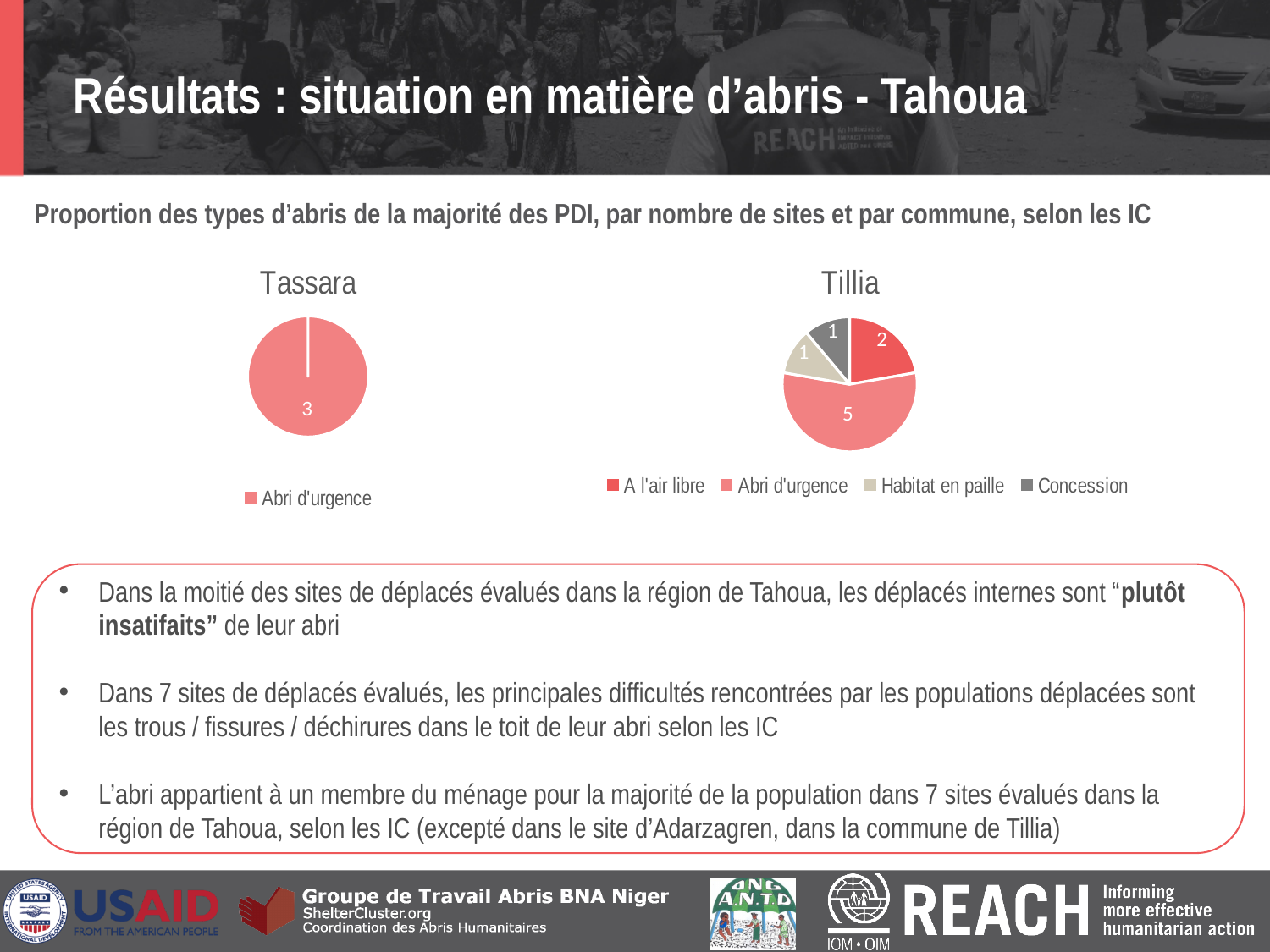
What kind of chart is the Tassara chart? pie chart In the Tillia chart, what is the value for Concession? 1 In the Tillia chart, what is the total of all slices? 9 In the Tillia chart, what is the value for A l'air libre? 2 In the Tillia chart, which is larger, A l'air libre or Habitat en paille? A l'air libre In the Tillia chart, how many categories does the legend list? 4 How many categories does the legend of the Tassara chart list? 1 In the Tillia chart, what is the value for Abri d'urgence? 5 In the Tillia chart, what is the difference between Abri d'urgence and A l'air libre? 3 In the Tillia chart, which category has the highest value? Abri d'urgence In the Tillia chart, what colour is the Abri d'urgence slice? light red / salmon In the Tassara chart, what is the value for Abri d'urgence? 3